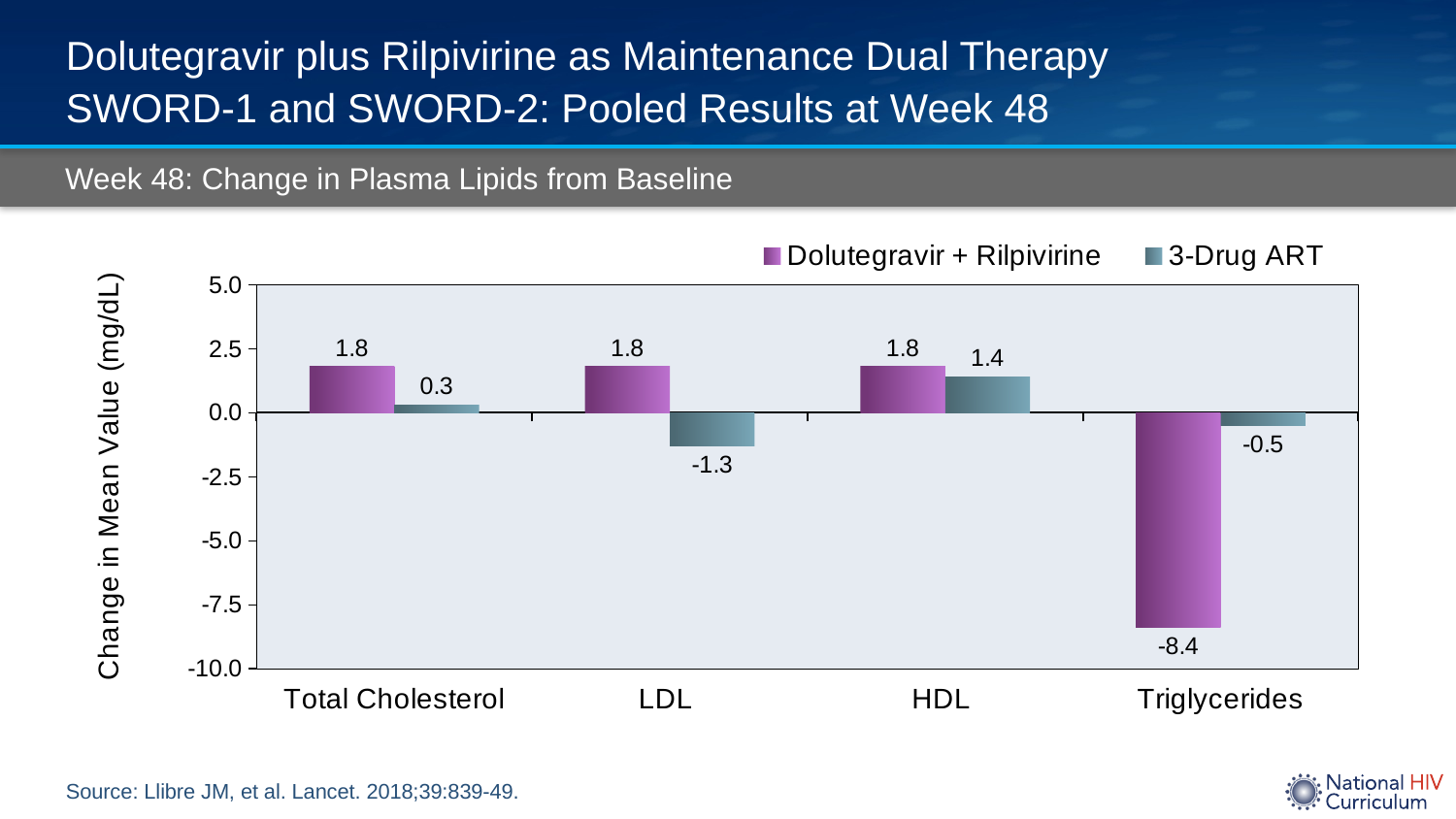
What is the change in mean value for HDL in the 3-Drug ART group? 1.4 Which lipid category has the highest value for the 3-Drug ART group? HDL What is the change in mean value for LDL in the 3-Drug ART group? -1.3 What is the change in mean value for Triglycerides in the Dolutegravir + Rilpivirine group? -8.4 What is the change in mean value for Total Cholesterol in the Dolutegravir + Rilpivirine group? 1.8 How many series does the legend list? 2 What kind of chart is shown on the slide? Bar chart What is the difference between the Dolutegravir + Rilpivirine and 3-Drug ART values for Total Cholesterol? 1.5 How many lipid categories are shown on the x axis? 4 Which lipid category has the lowest value for the Dolutegravir + Rilpivirine group? Triglycerides For LDL, which group has the larger change in mean value, Dolutegravir + Rilpivirine or 3-Drug ART? Dolutegravir + Rilpivirine What is the difference between the Dolutegravir + Rilpivirine and 3-Drug ART values for Triglycerides? 7.9